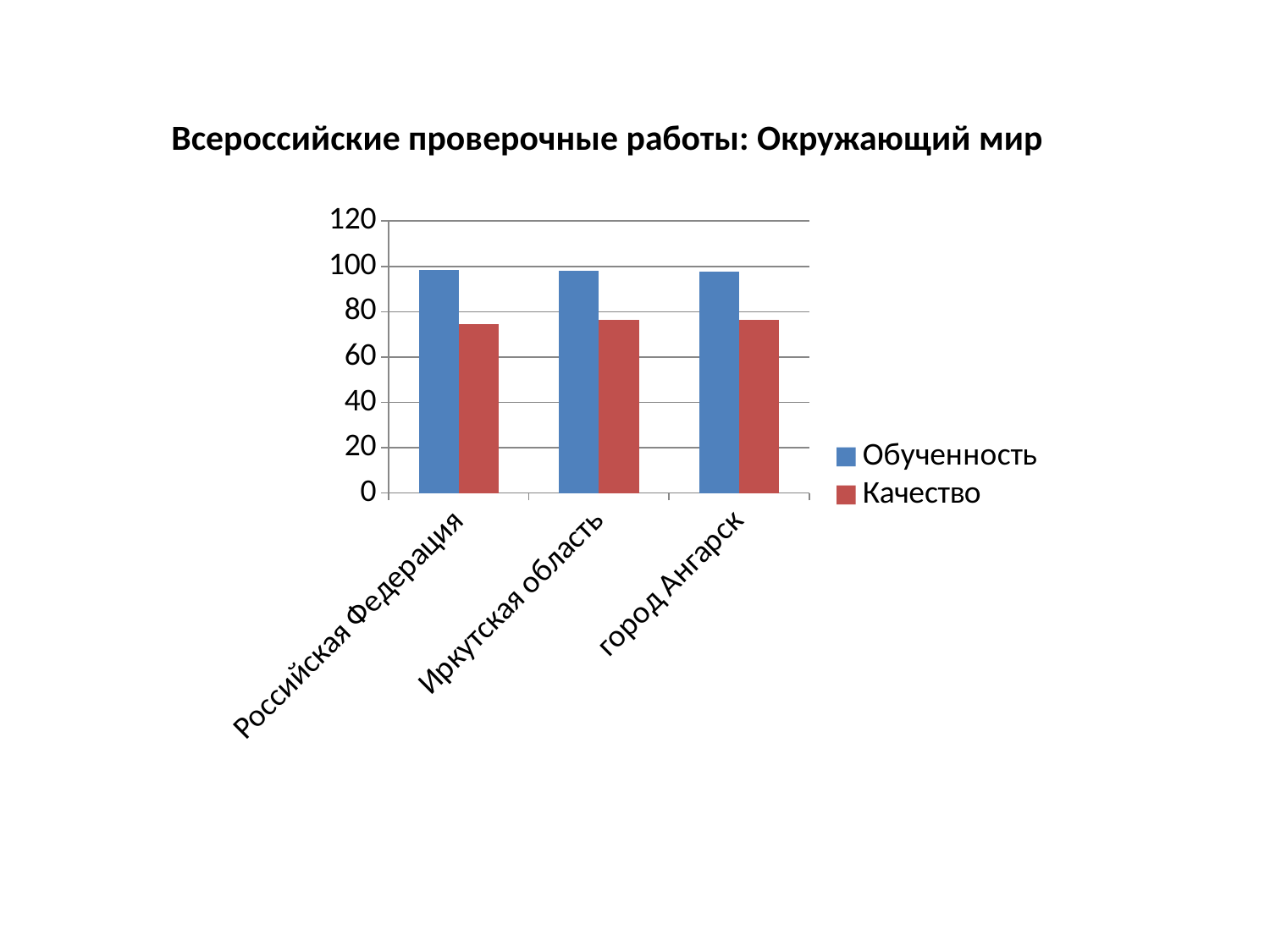
Which series is shown in blue? Обученность What is the title of the chart? Всероссийские проверочные работы: Окружающий мир How many categories are shown on the x axis? 3 For Российская Федерация, which is larger: Обученность or Качество? Обученность For Иркутская область, which is larger: Обученность or Качество? Обученность Is the Качество value for город Ангарск greater or less than 60? greater How many series does the legend list? 2 For город Ангарск, which is smaller: Обученность or Качество? Качество Is the Обученность value for город Ангарск greater or less than 100? less What kind of chart is shown on the slide? bar chart Is the Обученность value for Российская Федерация greater or less than 80? greater